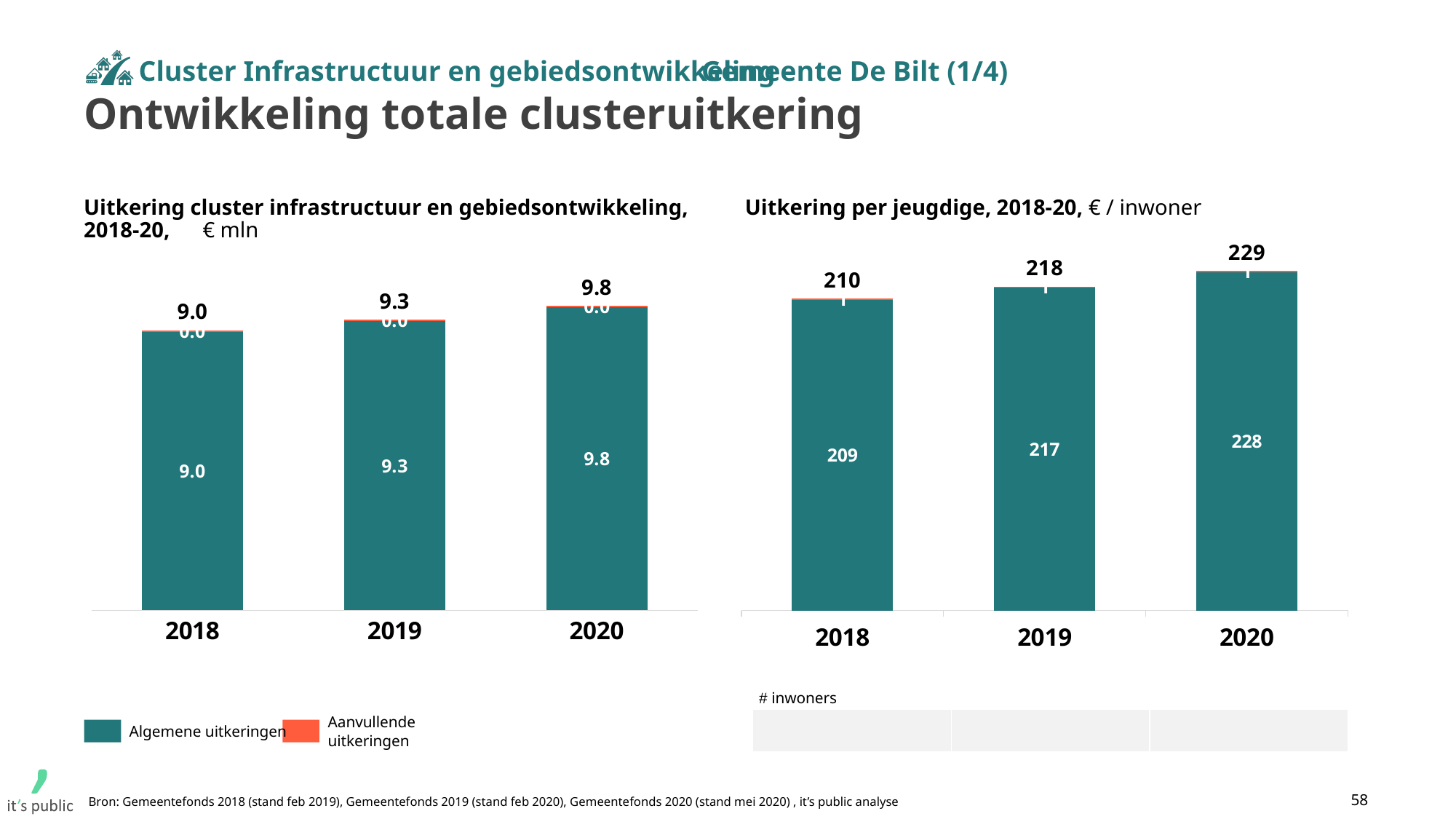
In the left chart (Uitkering cluster infrastructuur en gebiedsontwikkeling), what is the difference between the 2020 total and the 2018 total? 0.8 What kind of chart is the right chart (Uitkering per jeugdige)? bar chart In the right chart (Uitkering per jeugdige), what is the total value shown above the bar for 2019? 218 In the left chart (Uitkering cluster infrastructuur en gebiedsontwikkeling), what is the Algemene uitkeringen value for 2019? 9.3 In the left chart (Uitkering cluster infrastructuur en gebiedsontwikkeling), which year has the lowest total? 2018 How many series does the legend on the slide list? 2 In the right chart (Uitkering per jeugdige), what is the Algemene uitkeringen value for 2020? 228 In the right chart (Uitkering per jeugdige), what is the difference between the 2020 total and the 2018 total? 19 In the right chart (Uitkering per jeugdige), which year has the highest total? 2020 In the left chart (Uitkering cluster infrastructuur en gebiedsontwikkeling), do the totals rise or fall from 2018 to 2020? rise In the left chart (Uitkering cluster infrastructuur en gebiedsontwikkeling), what is the total value shown above the bar for 2020? 9.8 In the right chart (Uitkering per jeugdige), how many years are shown on the x axis? 3